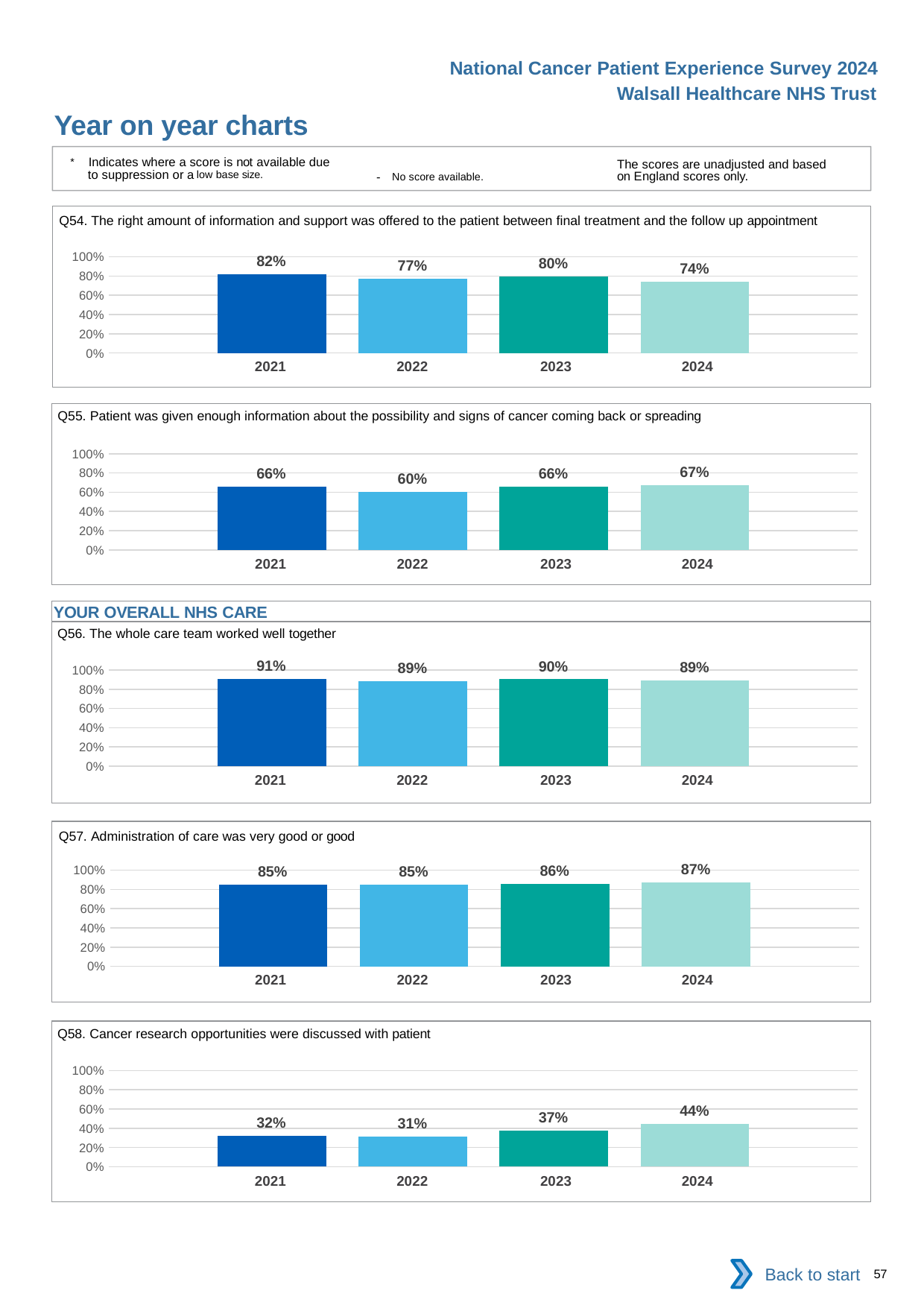
In the Q56 chart, how many years are plotted? 4 In the Q54 chart, which year has the highest value? 2021 In the Q55 chart, what is the value for 2022? 60% In the Q57 chart, what kind of chart is shown? Bar chart In the Q55 chart, what is the difference between the 2024 value and the 2022 value? 7% In the Q57 chart, what is the value for 2024? 87% In the Q58 chart, what is the difference between the 2024 value and the 2021 value? 12% In the Q56 chart, what is the value for 2021? 91% In the Q55 chart, which year has the lowest value? 2022 In the Q58 chart, which year has the highest value? 2024 In the Q54 chart, what is the value for 2024? 74% In the Q58 chart, is the value for 2023 larger or smaller than the value for 2022? Larger